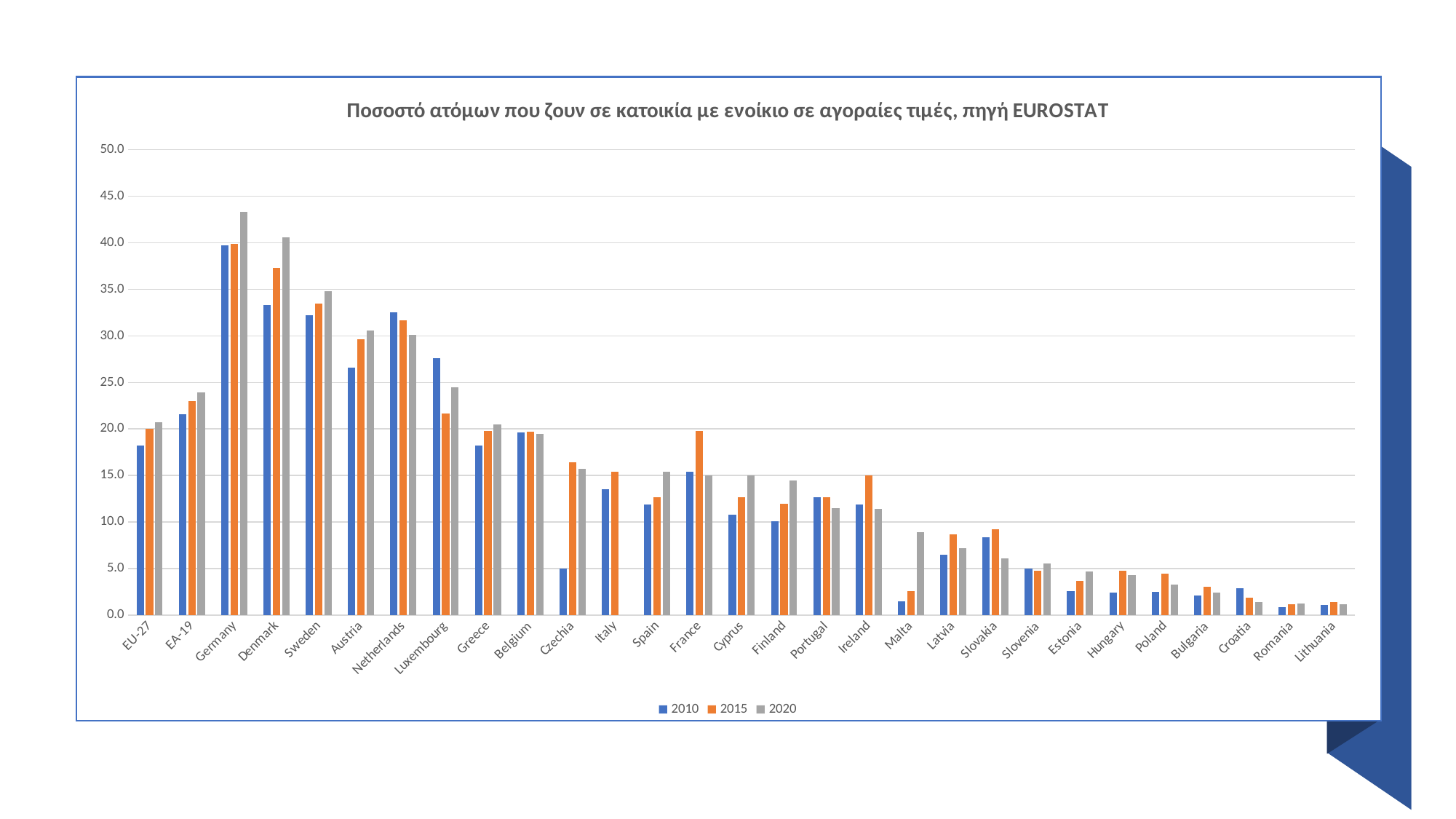
Which is larger for Luxembourg: the 2010 value or the 2020 value? 2010 Which is larger for Ireland: the 2015 value or the 2020 value? 2015 Is the value for France in 2015 greater or less than 15.0? greater Do the 2020 values generally rise or fall moving from left to right along the x axis? fall Is the value for Luxembourg in 2010 greater or less than 25.0? greater How many countries or regions are shown on the x axis? 29 Which category has the highest value for 2010? Germany What kind of chart is shown on the slide? bar chart Is the value for Czechia in 2010 greater or less than 10.0? less How many series does the legend list? 3 Which category has the highest value for 2020? Germany